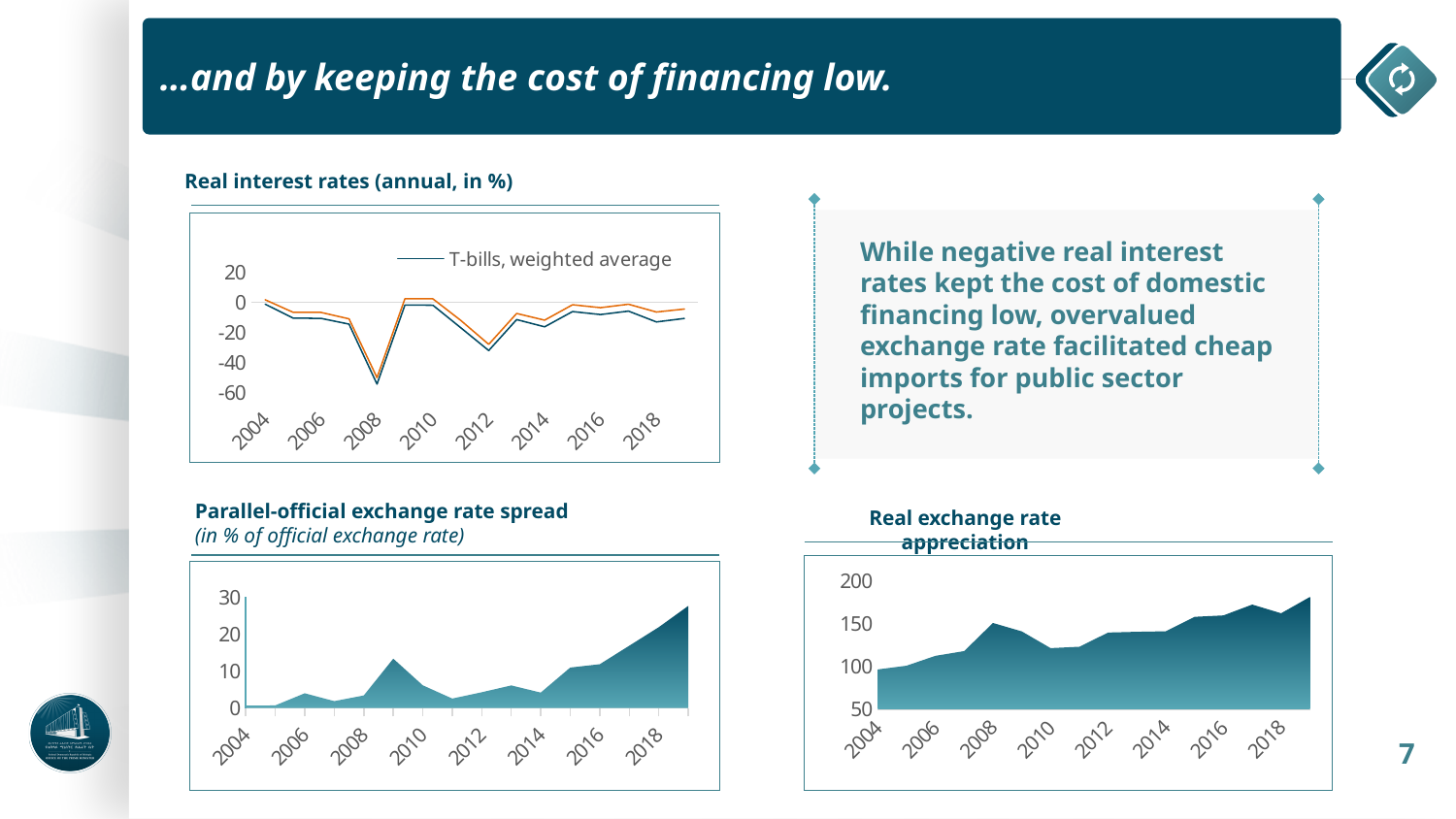
In the 'Parallel-official exchange rate spread' chart, is the value at the end of the period greater or less than 20? greater In the 'Real exchange rate appreciation' chart, is the value for 2018 greater or less than 150? greater In the 'Real exchange rate appreciation' chart, do values generally rise or fall from 2004 to the end of the period? rise In the 'Real exchange rate appreciation' chart, is the value for 2004 greater or less than 150? less What kind of chart is the 'Real interest rates (annual, in %)' chart? line chart In the 'Real interest rates (annual, in %)' chart, in which year do the lines reach their lowest point? 2008 In the 'Parallel-official exchange rate spread' chart, which is larger, the value for 2009 or the value for 2012? 2009 In the 'Real interest rates (annual, in %)' chart, what series does the legend list? T-bills, weighted average What kind of chart is the 'Parallel-official exchange rate spread' chart? area chart